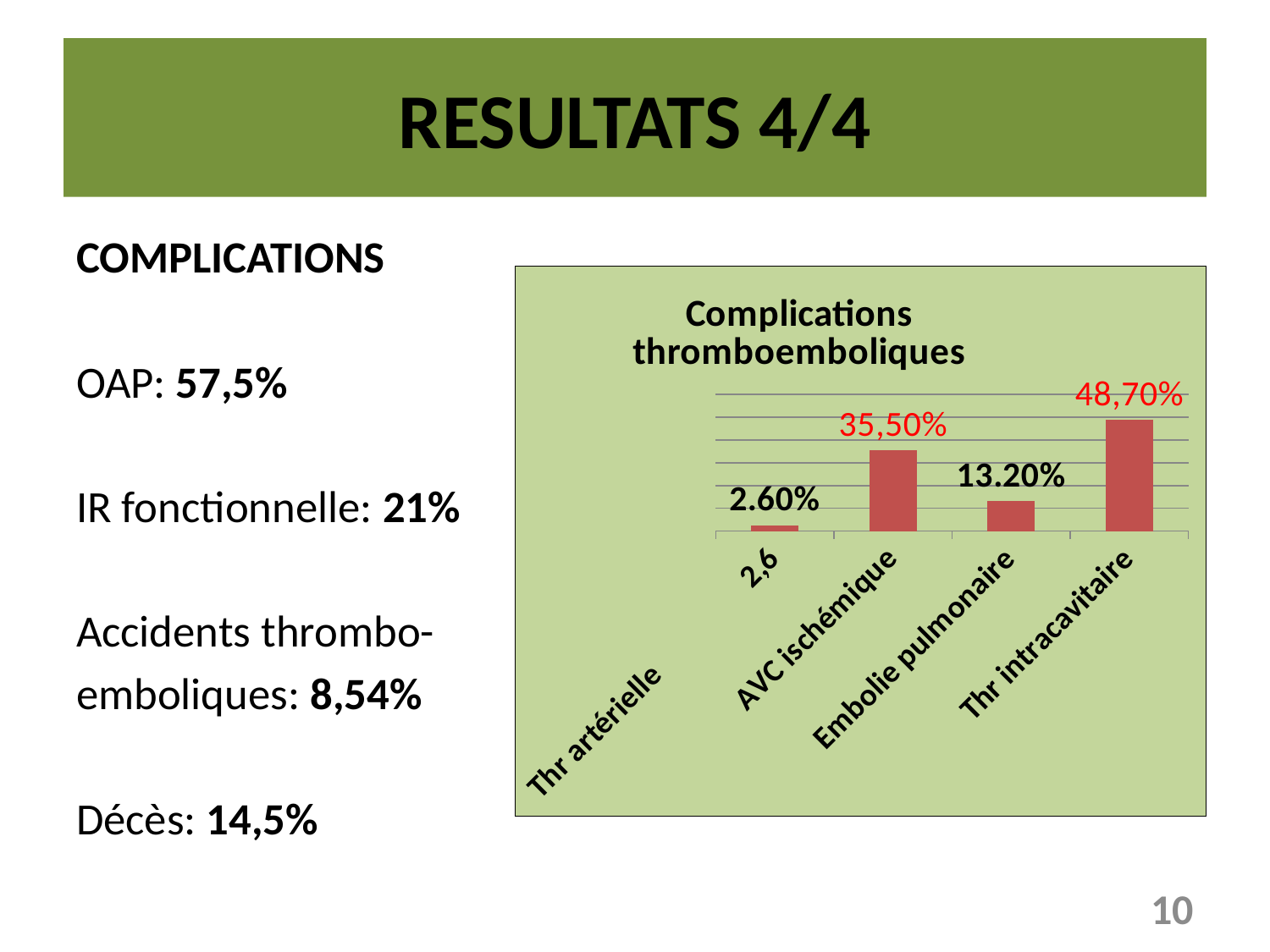
Which category has the lowest value? Thr artérielle What is the value for Embolie pulmonaire? 13.20% What kind of chart is shown on the slide? bar chart What is the difference between the values for Thr intracavitaire and AVC ischémique? 13,20% How many categories are shown in the chart? 4 What is the value for Thr artérielle? 2.60% What is the value for Thr intracavitaire? 48,70% Which is larger, the value for AVC ischémique or the value for Embolie pulmonaire? AVC ischémique Which category has the highest value? Thr intracavitaire What colour are the bars in the chart? red What is the title of the chart? Complications thromboemboliques What is the value for AVC ischémique? 35,50%